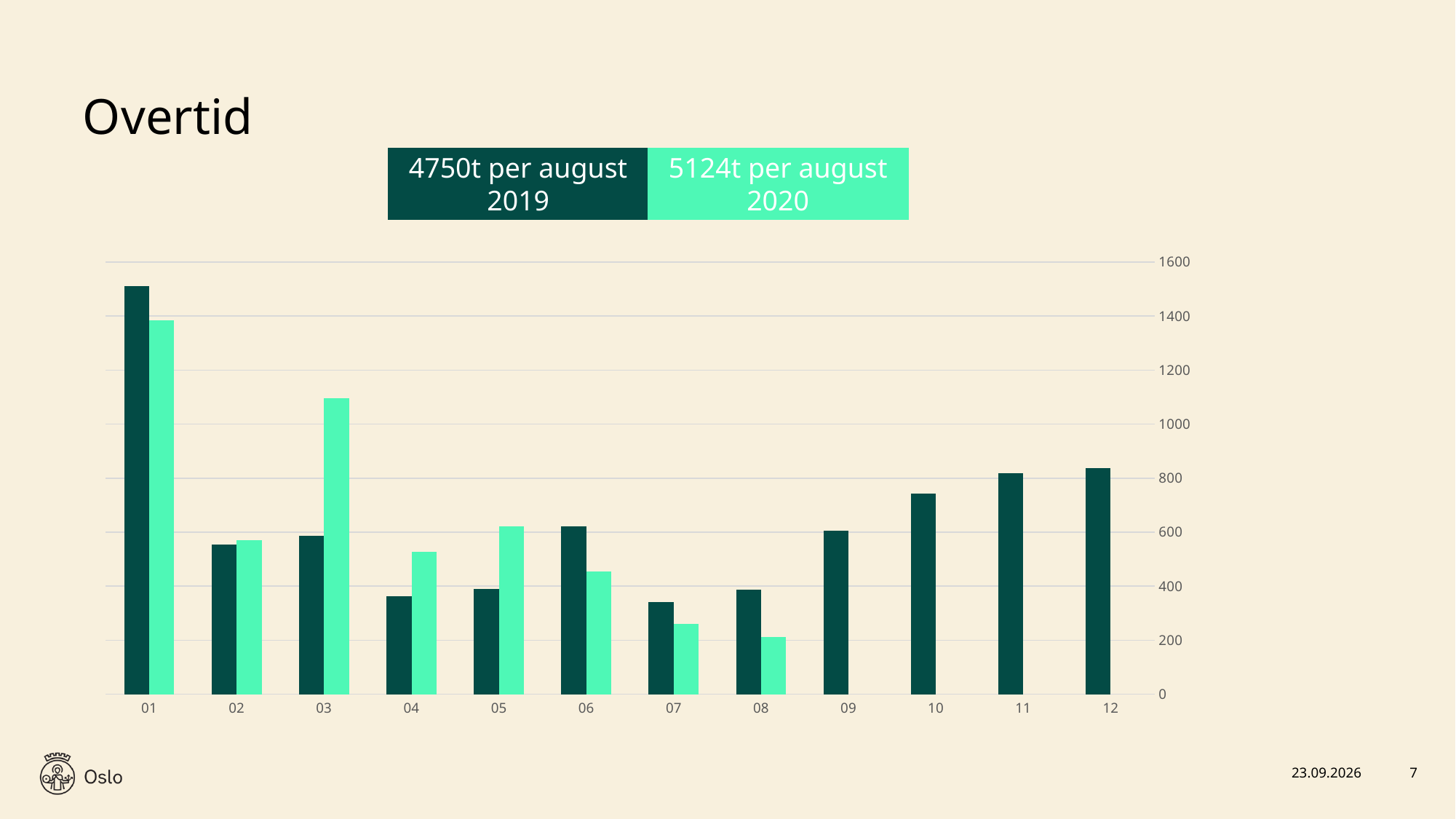
Is the 2020 value for month 03 greater or less than 1000? greater Do the 2019 values rise or fall from month 09 to month 12? rise Which month has the highest value for the 2020 series? 01 How many months (categories) are shown on the x axis? 12 Which month has the lowest value for the 2020 series? 08 For month 03, which series has the larger value, 2019 or 2020? 2020 What kind of chart is shown on the slide? bar chart Which month has the highest value for the 2019 series? 01 Is the 2019 value for month 01 greater or less than 1400? greater Is the 2019 value for month 04 greater or less than 400? less For month 06, which series has the larger value, 2019 or 2020? 2019